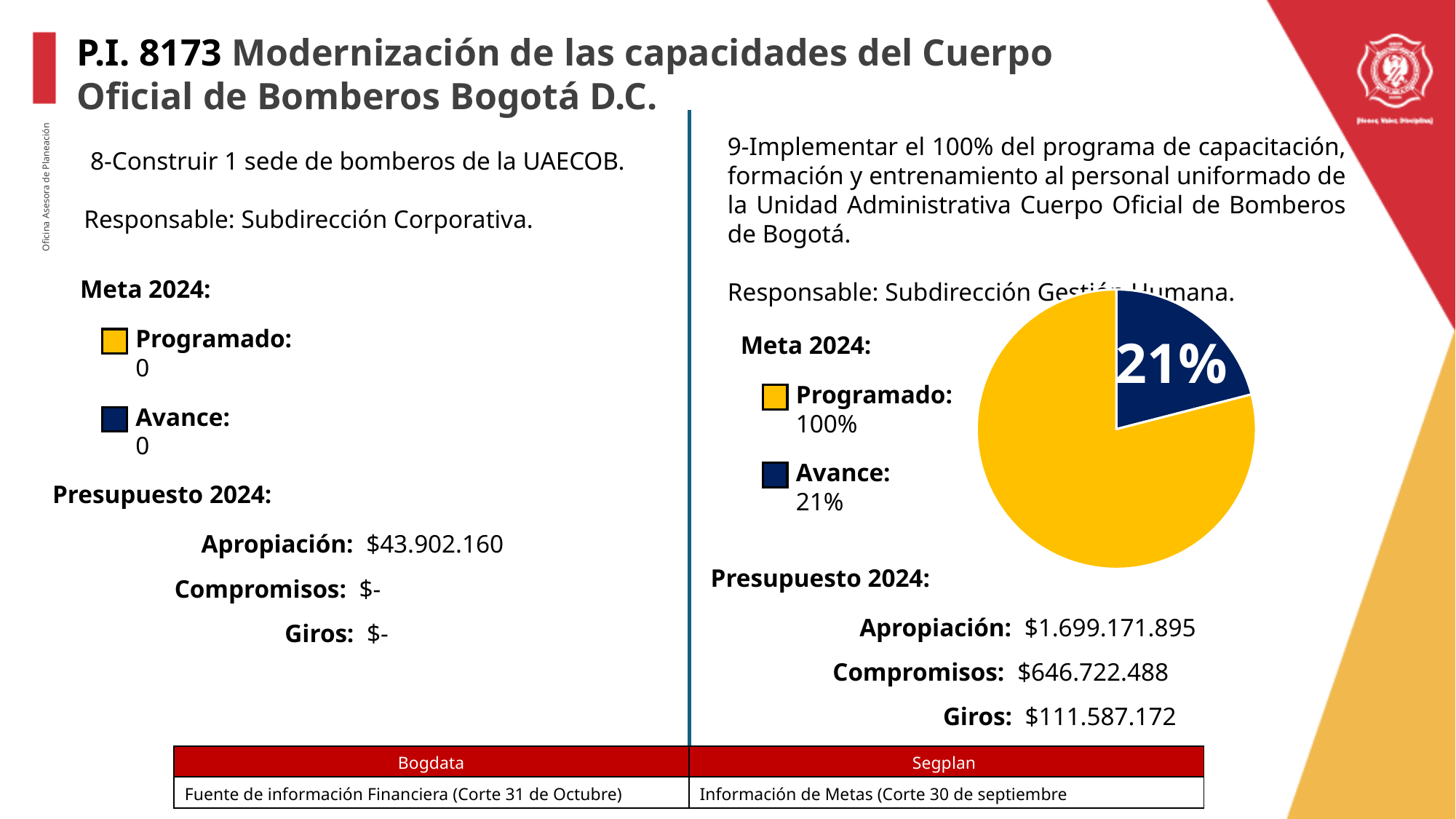
Which slice of the pie chart is the smallest? the dark blue (Avance) slice Which slice of the pie chart is larger, the yellow one or the dark blue one? the yellow one According to the legend next to the pie chart, what value is given for Programado? 100% What colour is the slice labelled 21% in the pie chart? dark blue How many slices does the pie chart have? 2 Which slice of the pie chart is the largest? the yellow (Programado) slice What kind of chart is shown on the right side of the slide? pie chart According to the legend next to the pie chart, what value is given for Avance? 21% What share of the pie does the dark blue (Avance) slice represent? 21% Is the share of the dark blue slice in the pie chart greater or less than 50%? less What value is printed on the dark blue slice of the pie chart? 21% How many entries does the legend next to the pie chart list? 2